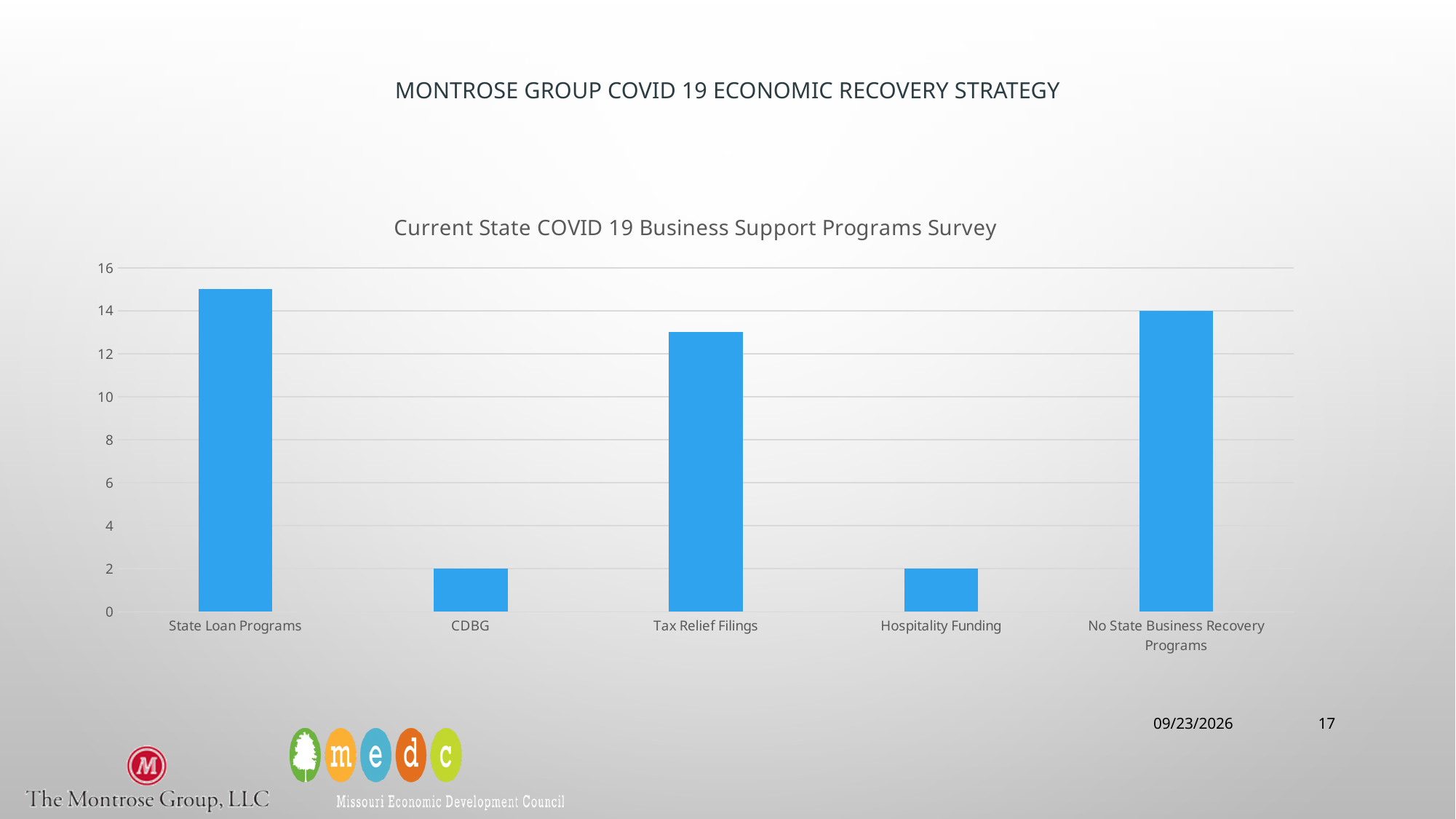
Which category has the highest value? State Loan Programs What is the title of the chart? Current State COVID 19 Business Support Programs Survey What is the value for CDBG? 2 What is the difference between the value for No State Business Recovery Programs and the value for CDBG? 12 What is the value for No State Business Recovery Programs? 14 Which is larger, the value for State Loan Programs or the value for Tax Relief Filings? State Loan Programs Is the value for Tax Relief Filings greater or less than 12? greater Is the value for State Loan Programs greater or less than 14? greater How many categories are shown on the x axis of the chart? 5 What is the value for Hospitality Funding? 2 What type of chart is shown on the slide? bar chart Is the value for Tax Relief Filings greater or less than 14? less